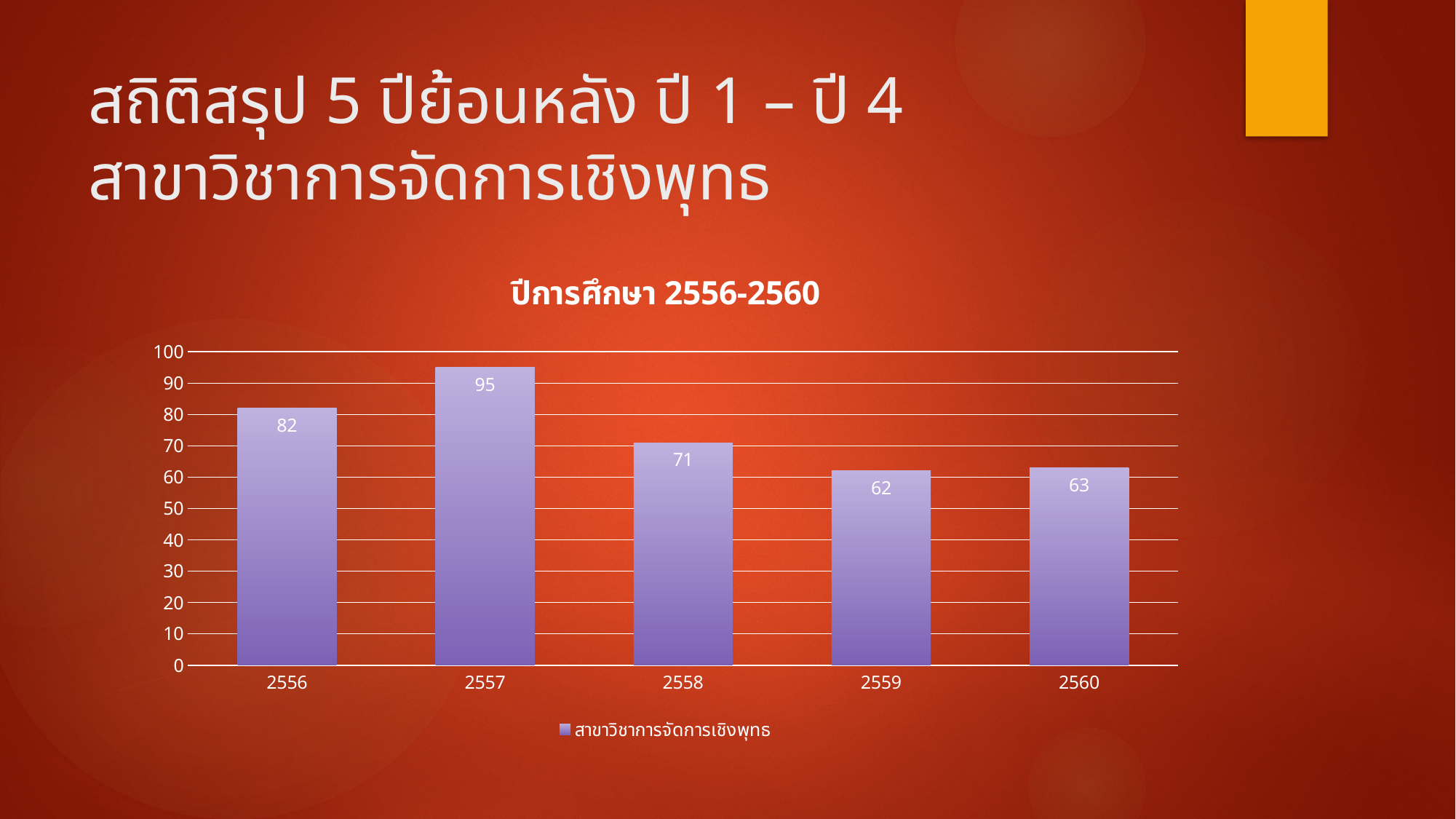
Which is larger, the value for 2556 or the value for 2558? 2556 What is the title of the chart? ปีการศึกษา 2556-2560 What is the value for 2558? 71 How many years are shown on the x axis? 5 What kind of chart is shown on the slide? Bar chart What is the value for 2560? 63 What is the value for 2559? 62 Which year has the lowest value? 2559 Which year has the highest value? 2557 What is the value for 2556? 82 What is the difference between the values for 2557 and 2556? 13 What is the value for 2557? 95